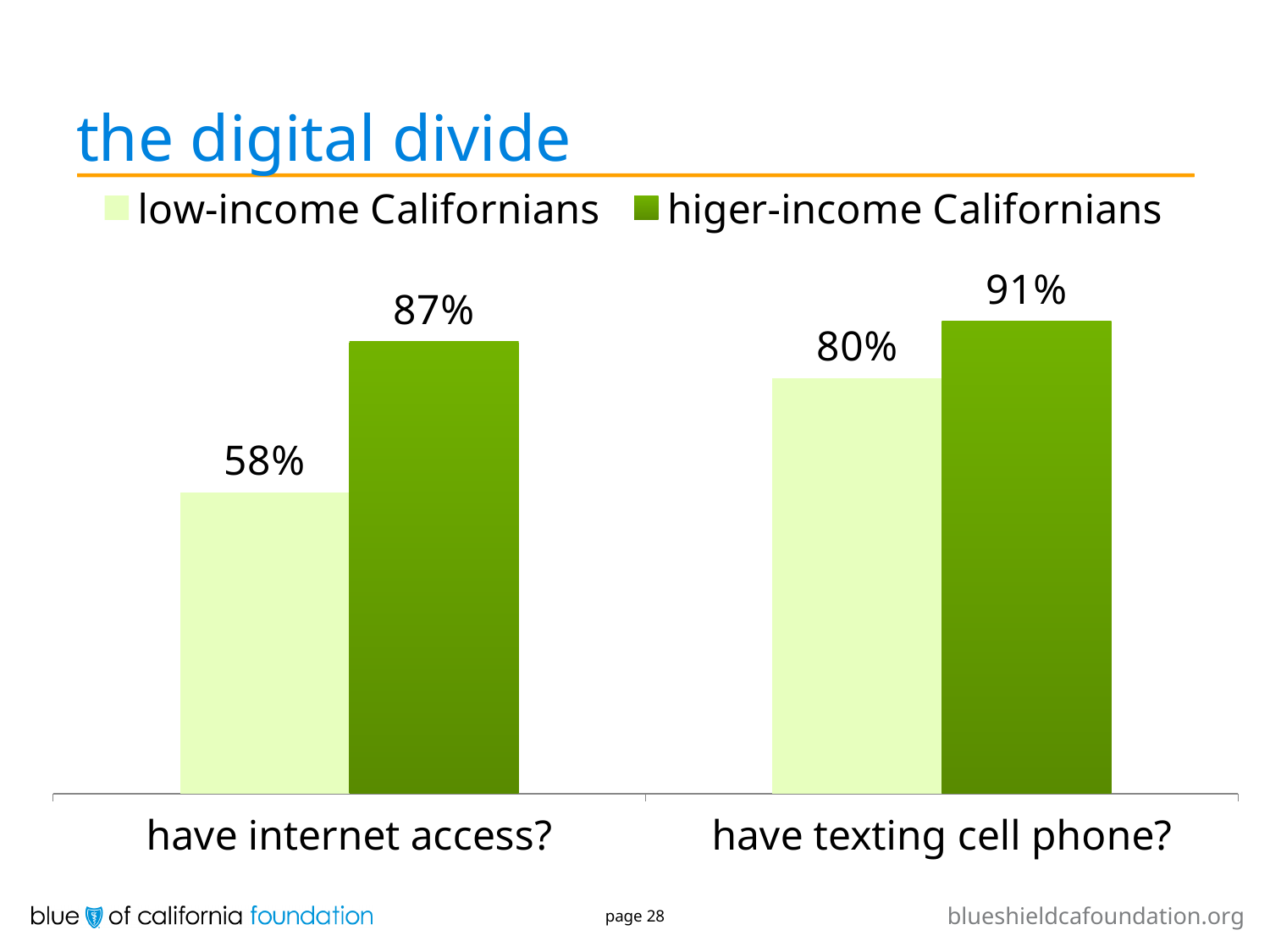
What is the difference in percentage points between higher-income and low-income Californians who have a texting cell phone? 11 percentage points Which bar shows the lowest value on the chart? low-income Californians, have internet access? (58%) What percentage of higher-income Californians have a texting cell phone? 91% Which bar shows the highest value on the chart? higher-income Californians, have texting cell phone? (91%) How many series does the legend list? 2 What percentage of low-income Californians have a texting cell phone? 80% What type of chart is shown on the slide? bar chart Which is larger: the share of low-income Californians with a texting cell phone or the share of low-income Californians with internet access? texting cell phone (80%) What percentage of low-income Californians have internet access? 58% What is the difference in percentage points between higher-income and low-income Californians who have internet access? 29 percentage points What percentage of higher-income Californians have internet access? 87% How many categories are shown on the x axis? 2